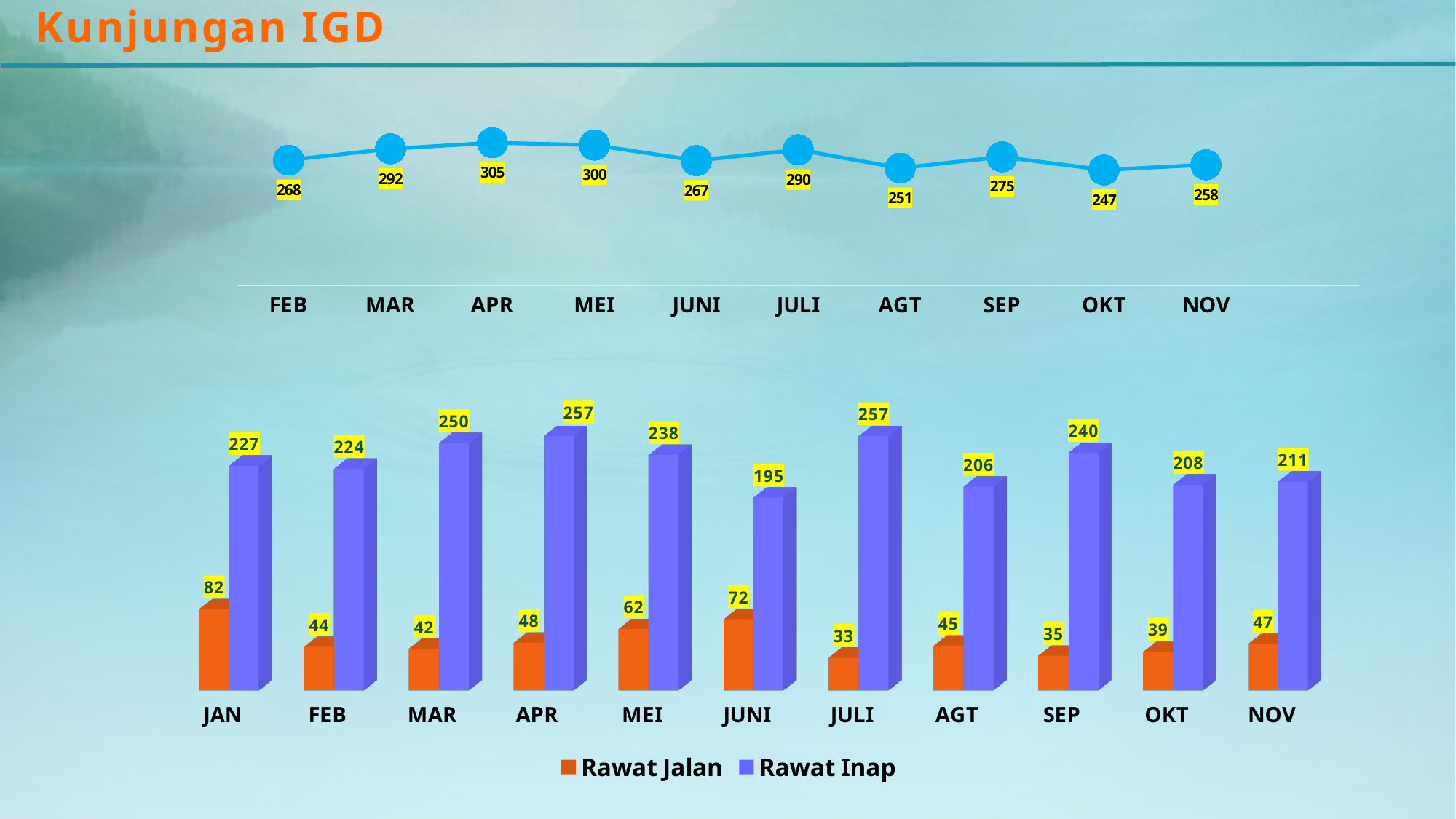
In the bottom bar chart, which is larger for AGT: Rawat Jalan or Rawat Inap? Rawat Inap In the top line chart, what is the value for APR? 305 In the bottom bar chart, how many series does the legend list? 2 In the bottom bar chart, which month has the lowest Rawat Inap value? JUNI In the top line chart, which month has the highest value? APR What type of chart is the bottom chart? Bar chart In the bottom bar chart, what is the Rawat Jalan value for MEI? 62 In the bottom bar chart, what is the Rawat Inap value for SEP? 240 In the top line chart, which month has the lowest value? OKT In the bottom bar chart, which month has the highest Rawat Jalan value? JAN In the top line chart, how many data points are plotted? 10 In the top line chart, what is the difference between the values for MAR and FEB? 24